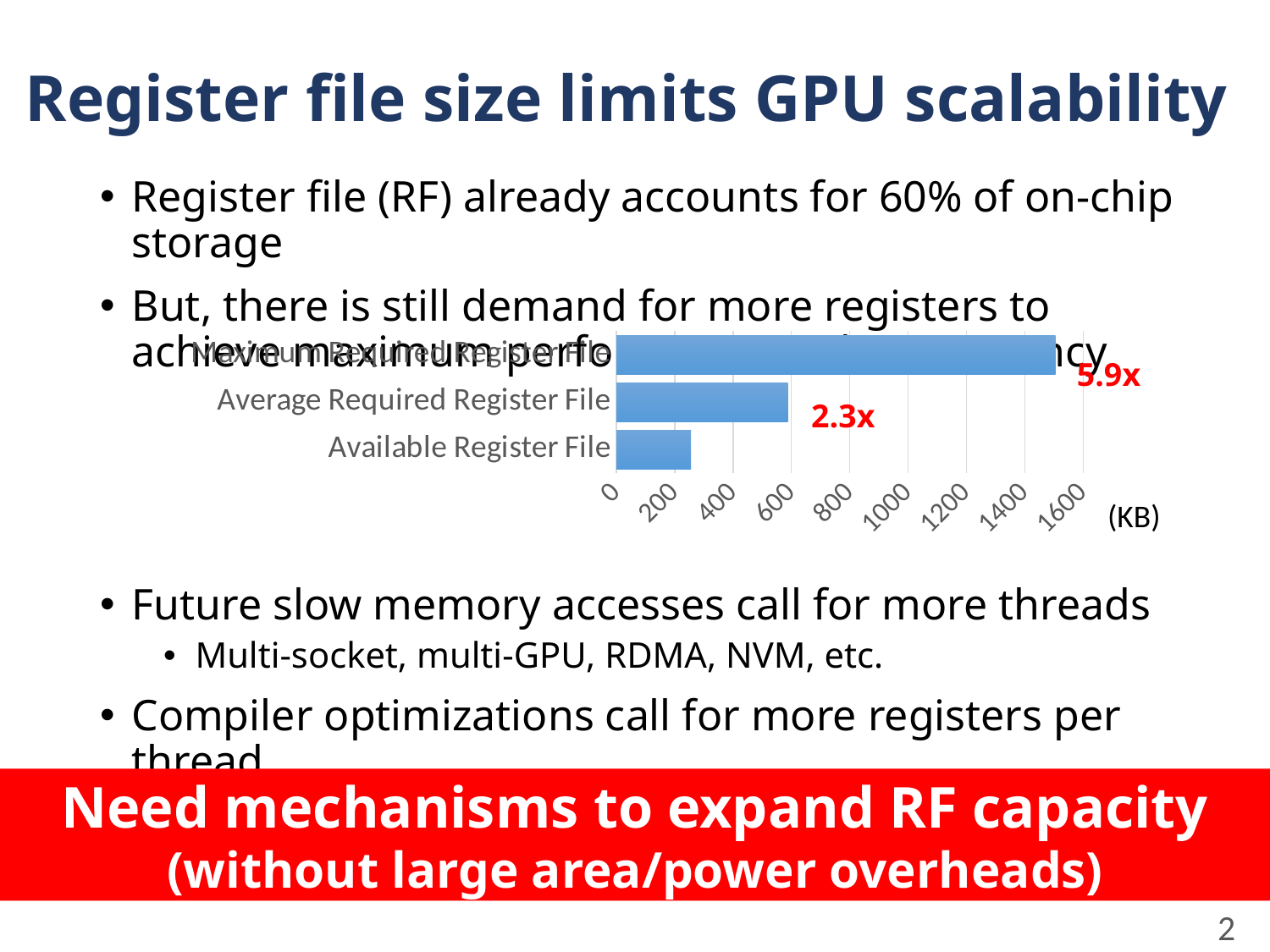
Which category has the smallest bar in the chart? Available Register File Is the value for Maximum Required Register File greater or less than 1600? less How many categories (bars) does the chart show? 3 Is the value for Average Required Register File greater or less than 400? greater Which category has the largest bar in the chart? Maximum Required Register File Is the value for Maximum Required Register File greater or less than 1400? greater Which is larger, the Average Required Register File or the Available Register File? Average Required Register File What unit is shown for the chart's horizontal axis? KB What kind of chart is shown on the slide? bar chart What multiplier is printed next to the Average Required Register File bar? 2.3x